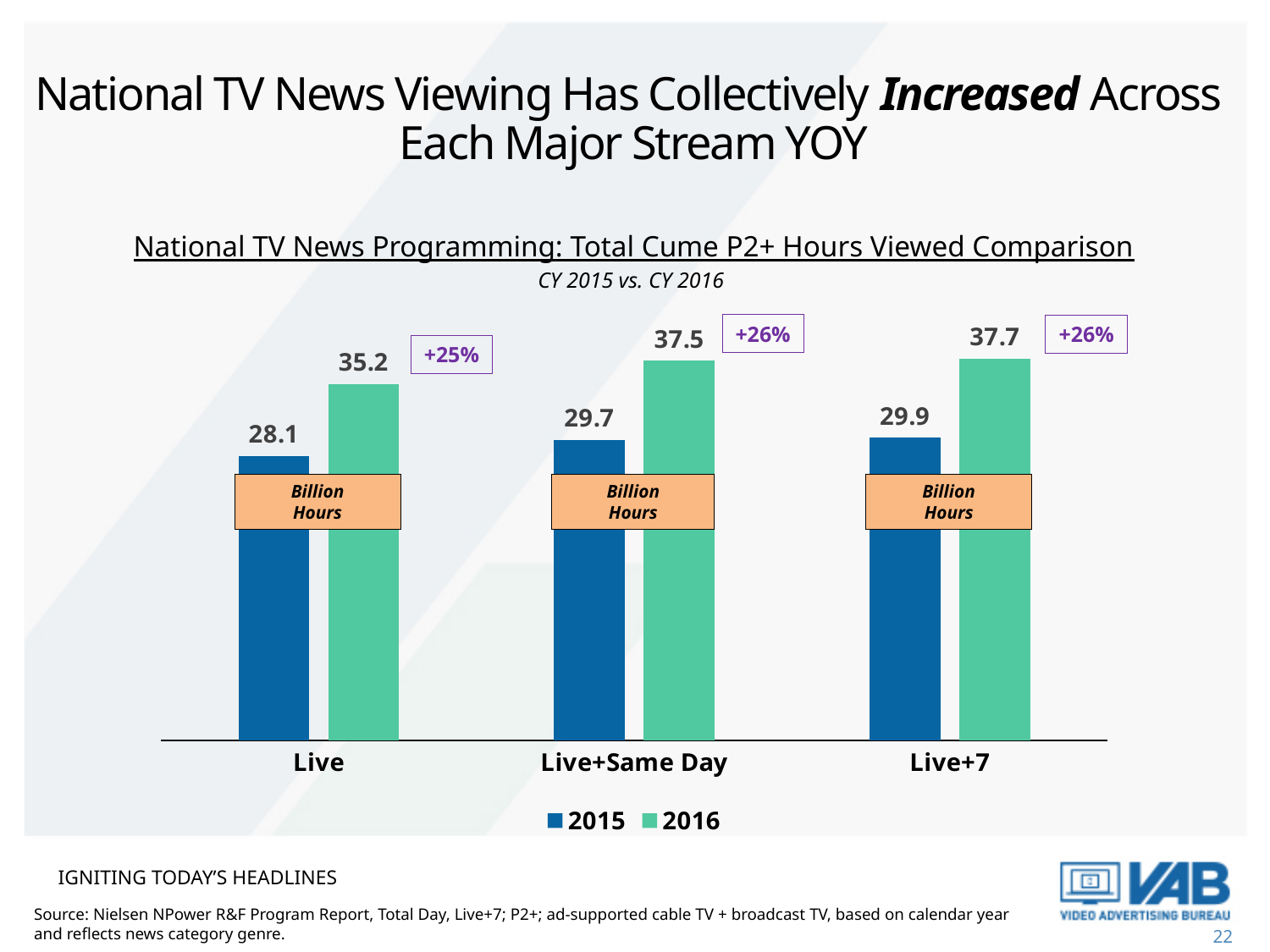
What percentage change is shown for Live+Same Day? +26% What is the 2016 value for Live+Same Day? 37.5 How many categories are shown on the x axis? 3 What is the 2016 value for Live+7? 37.7 What is the 2015 value for Live? 28.1 Which is larger, the 2016 value for Live or the 2015 value for Live+7? 2016 value for Live What kind of chart is shown? Bar chart What is the 2015 value for Live+7? 29.9 What is the difference between the 2016 and 2015 values for Live? 7.1 How many series does the legend list? 2 What is the difference between the 2016 and 2015 values for Live+Same Day? 7.8 Which category has the lowest 2015 value? Live